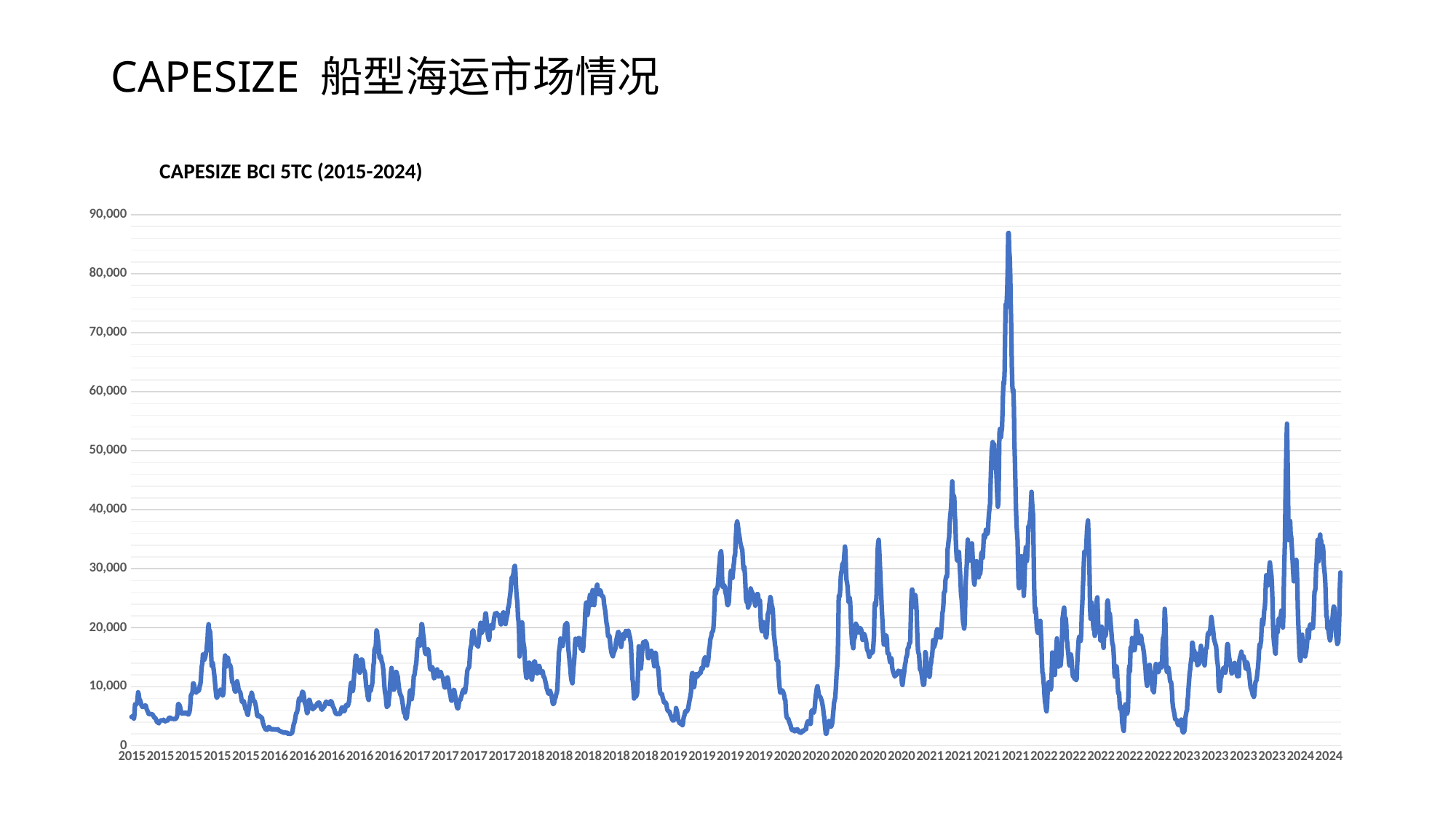
Is the sharp spike in late 2023 greater or less than 60,000? less Is the value at the start of 2016 greater or less than 10,000? less What kind of chart is shown on the slide? line chart What is the highest value shown on the vertical axis? 90,000 Is the highest peak of the line, in 2021, greater or less than 90,000? less What is the title of the chart? CAPESIZE BCI 5TC (2015-2024) Which is higher: the peak in 2021 or the peak in 2023? the peak in 2021 In which year does the line reach its highest peak? 2021 How many lines (series) are plotted on the chart? 1